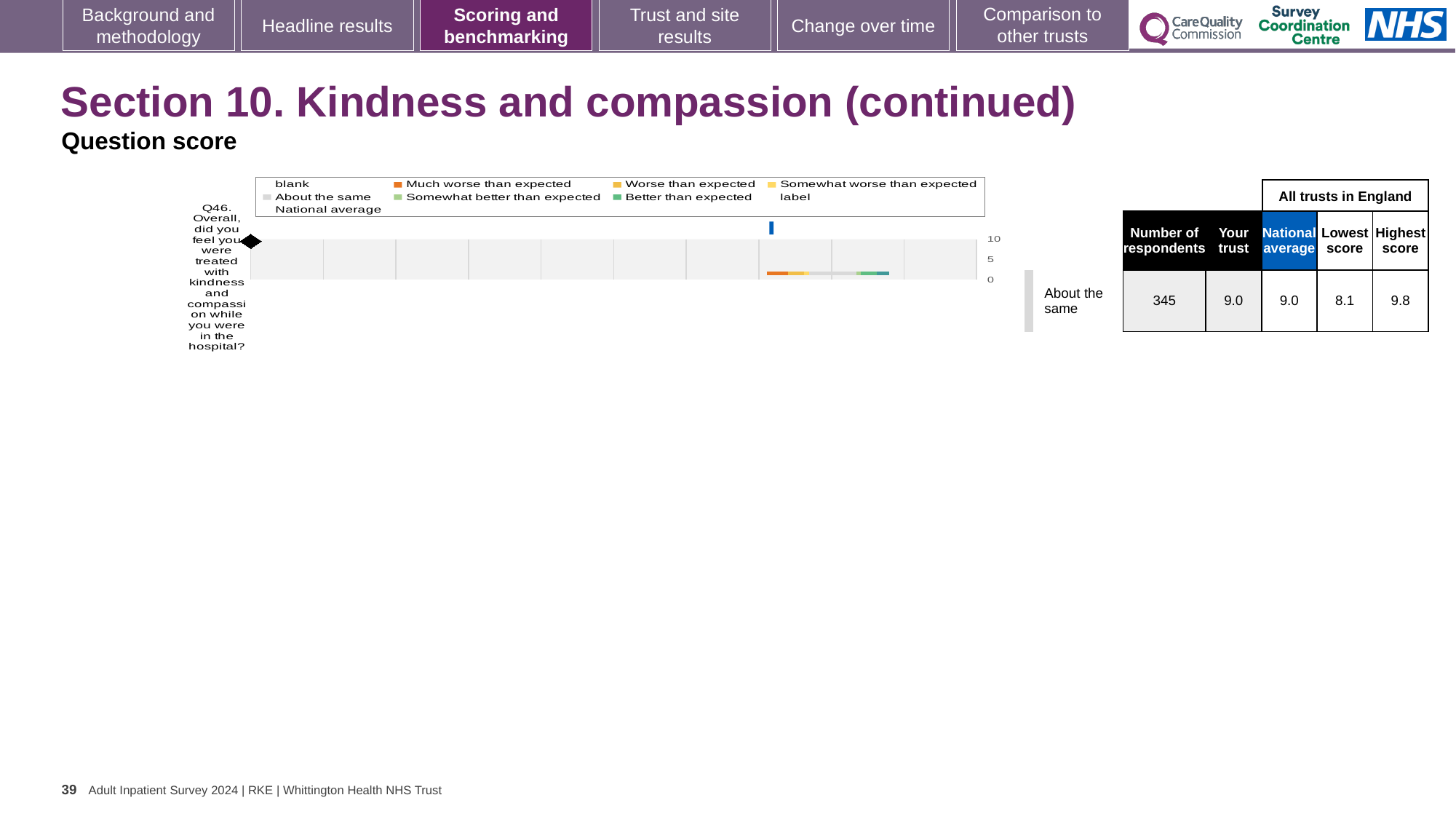
Is the 'Your trust' score for Q46 higher than, lower than, or the same as the national average? the same What is the difference between the highest score and the lowest score for Q46 in the table? 1.7 What kind of chart is used to show the Q46 question score? bar chart According to the table, what is the national average score for Q46? 9.0 How many respondents answered Q46 according to the table? 345 What is the highest tick value shown on the chart's score axis? 10 Which question is plotted on the question score chart? Q46. Overall, did you feel you were treated with kindness and compassion while you were in the hospital? According to the table, what is the lowest score among all trusts in England for Q46? 8.1 According to the table, what is the highest score among all trusts in England for Q46? 9.8 Is the national average marker on the chart for Q46 greater or less than 5? greater How many questions are plotted on the question score chart? 1 According to the table, what is the 'Your trust' score for Q46? 9.0